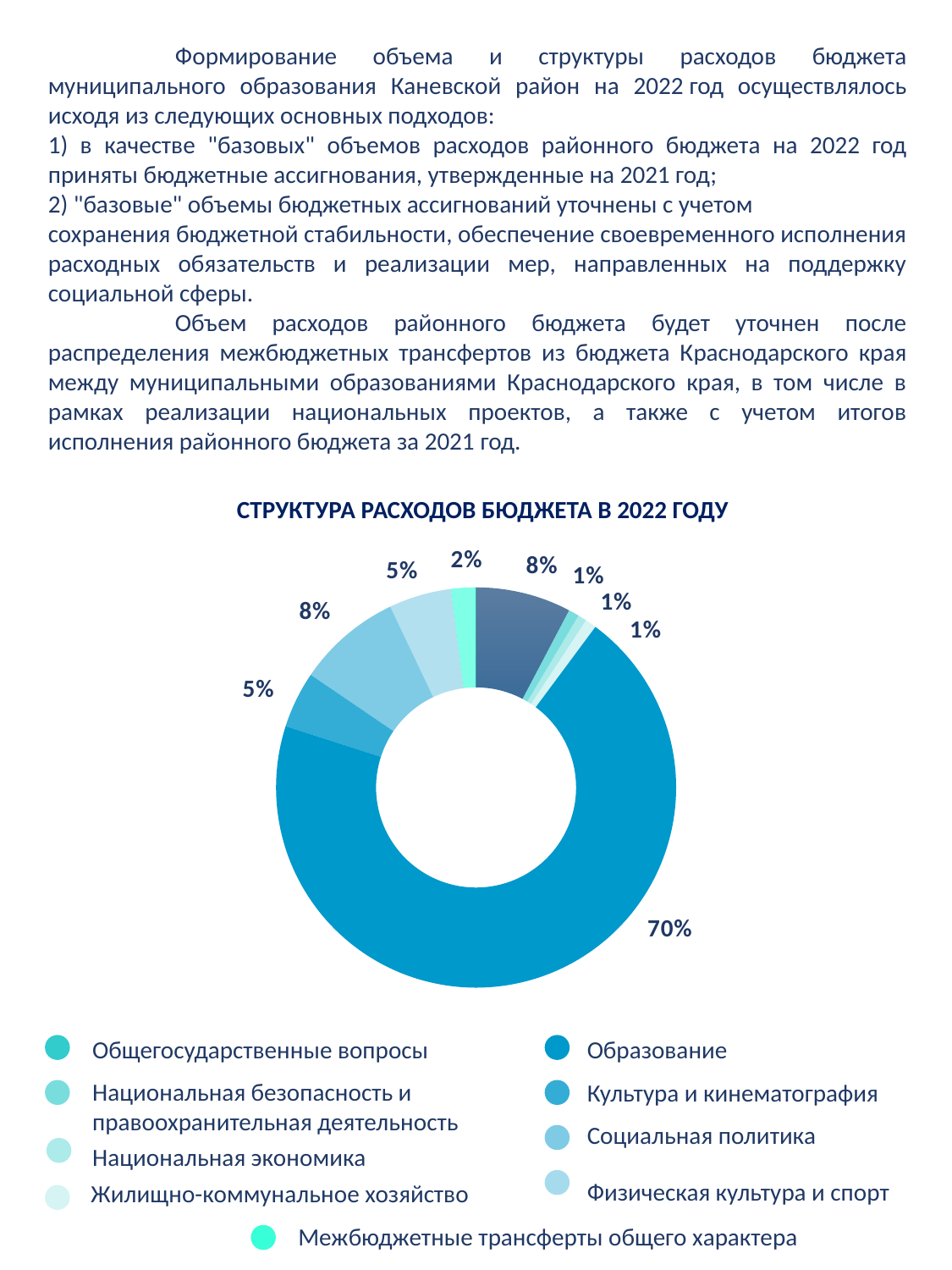
Which is larger: the share for Социальная политика or the share for Культура и кинематография? Социальная политика Which category has the largest share of the 2022 budget expenditure? Образование What share of the 2022 budget expenditure goes to Межбюджетные трансферты общего характера? 2% What share of the 2022 budget expenditure goes to Социальная политика? 8% What share of the 2022 budget expenditure goes to Культура и кинематография? 5% What is the title of the chart? СТРУКТУРА РАСХОДОВ БЮДЖЕТА В 2022 ГОДУ What share of the 2022 budget expenditure goes to Физическая культура и спорт? 5% How many categories does the legend of the chart list? 9 Is the share for Образование greater or less than 50%? greater What share of the 2022 budget expenditure goes to Образование? 70% What kind of chart is shown on the slide? Pie (donut) chart What is the difference between the share for Образование and the share for Социальная политика? 62%